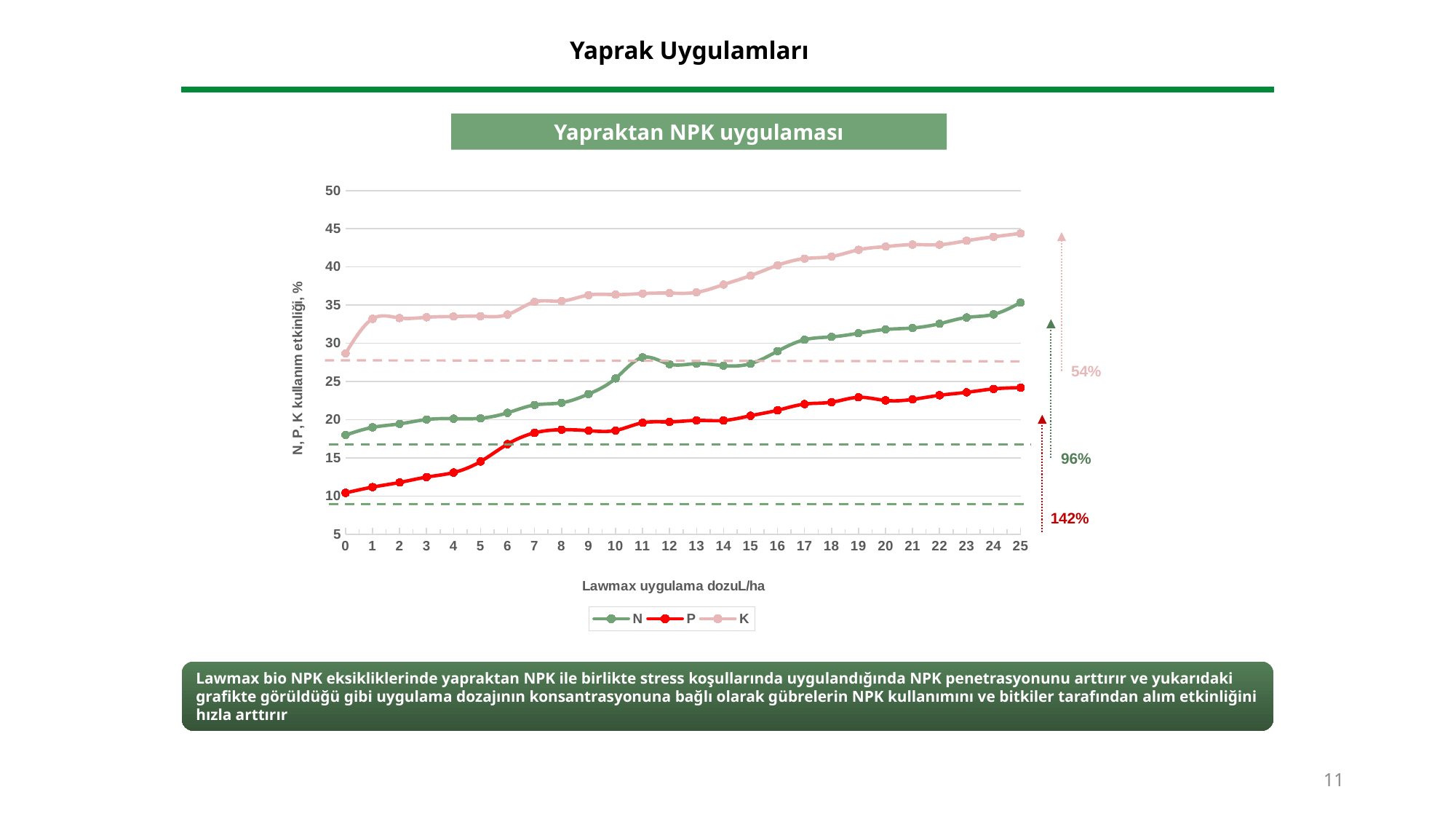
What kind of chart is shown on the slide? line chart How many series does the legend list? 3 Is the value for N at x = 0 greater or less than 20? less Is the value for N at x = 25 greater or less than 30? greater Do the values for the P series rise or fall as the x axis goes from 0 to 25? rise How many points are plotted along the x axis for each series (from 0 to 25)? 26 Which series has the highest value at x = 25? K Which series has the lowest value at x = 0? P At x = 25, which is larger, the value for K or the value for N? K What is the title shown above the chart? Yapraktan NPK uygulaması Is the value for P at x = 0 greater or less than 15? less